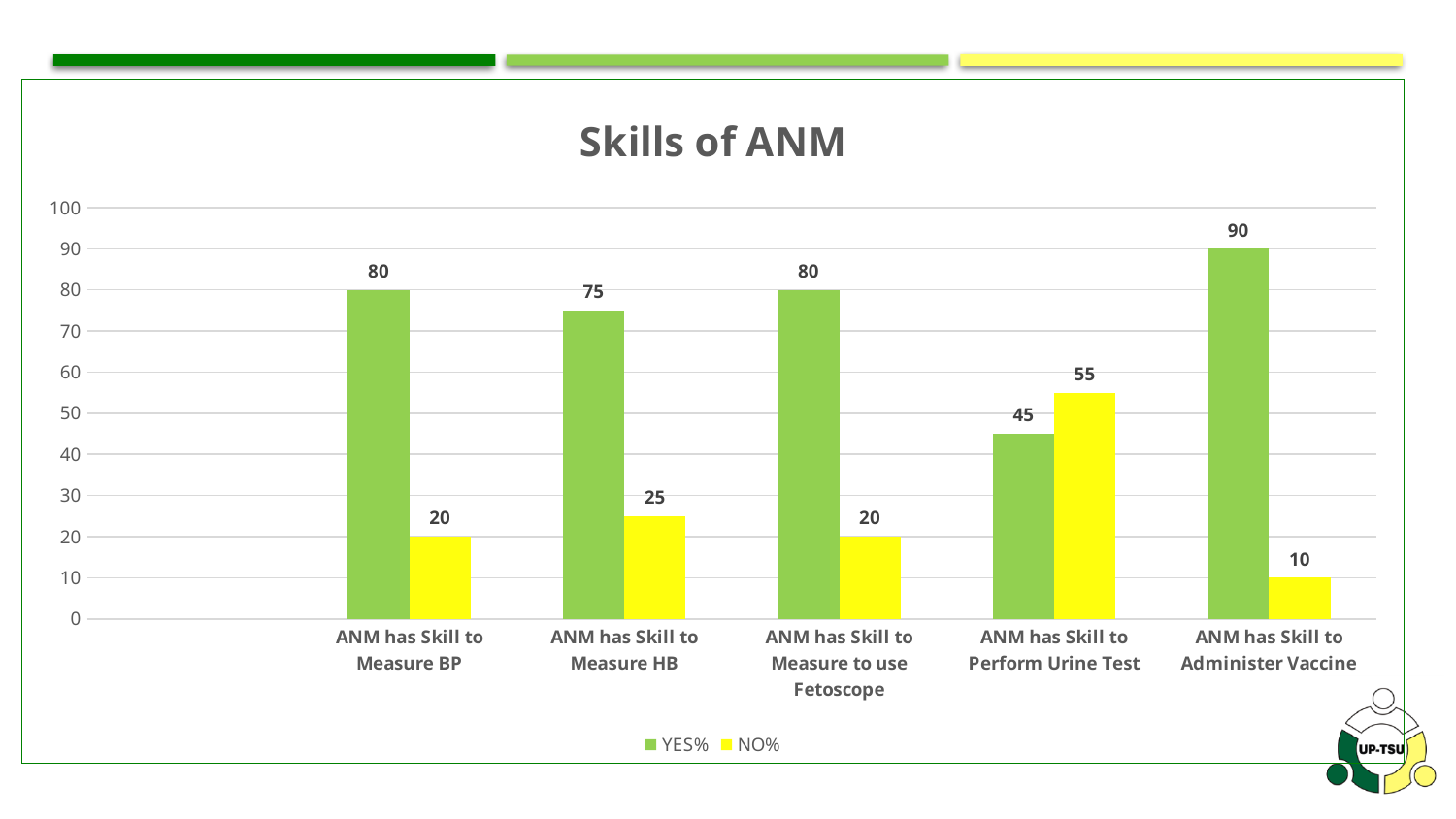
How many categories are shown on the x axis? 5 What is the YES% value for 'ANM has Skill to Measure BP'? 80 What is the title of the chart? Skills of ANM What kind of chart is shown on the slide? Bar chart Which is larger for 'ANM has Skill to Perform Urine Test': the YES% value or the NO% value? NO% Which category has the highest YES% value? ANM has Skill to Administer Vaccine Which category has the lowest NO% value? ANM has Skill to Administer Vaccine What colour represents the NO% series? Yellow What is the difference between the YES% and NO% values for 'ANM has Skill to Perform Urine Test'? 10 What is the NO% value for 'ANM has Skill to Measure HB'? 25 What is the YES% value for 'ANM has Skill to Perform Urine Test'? 45 How many series does the legend list? 2